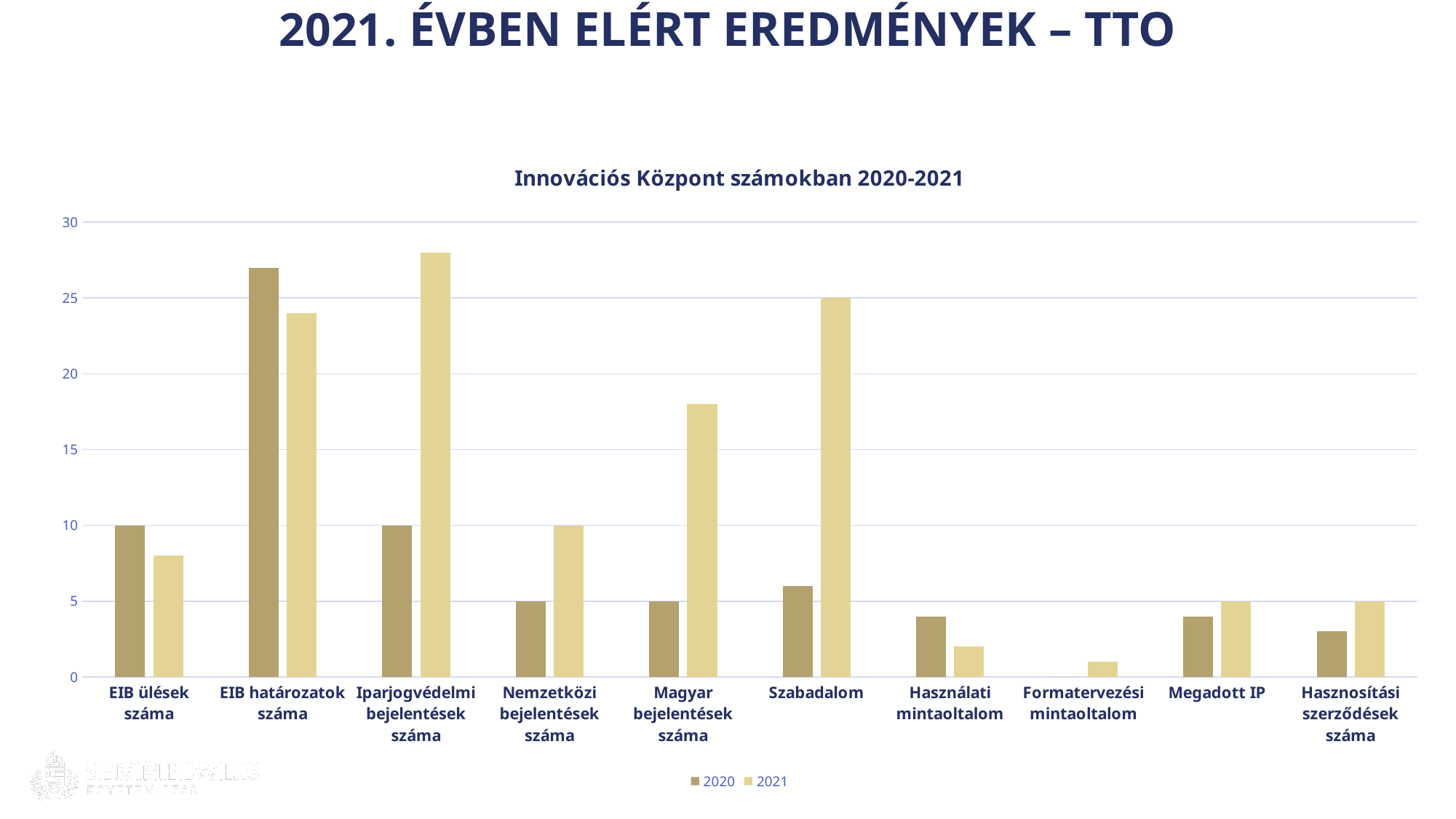
What is the 2020 value for EIB ülések száma? 10 For EIB határozatok száma, which year has the larger value, 2020 or 2021? 2020 What is the title of the chart? Innovációs Központ számokban 2020-2021 What is the 2021 value for Nemzetközi bejelentések száma? 10 What is the 2020 value for Magyar bejelentések száma? 5 Is the 2021 value for Magyar bejelentések száma greater or less than 15? greater How many categories are shown on the x axis? 10 What is the 2021 value for Szabadalom? 25 What kind of chart is shown on the slide? bar chart Which category has the highest 2020 value? EIB határozatok száma Which category has the highest 2021 value? Iparjogvédelmi bejelentések száma How many series does the legend list? 2